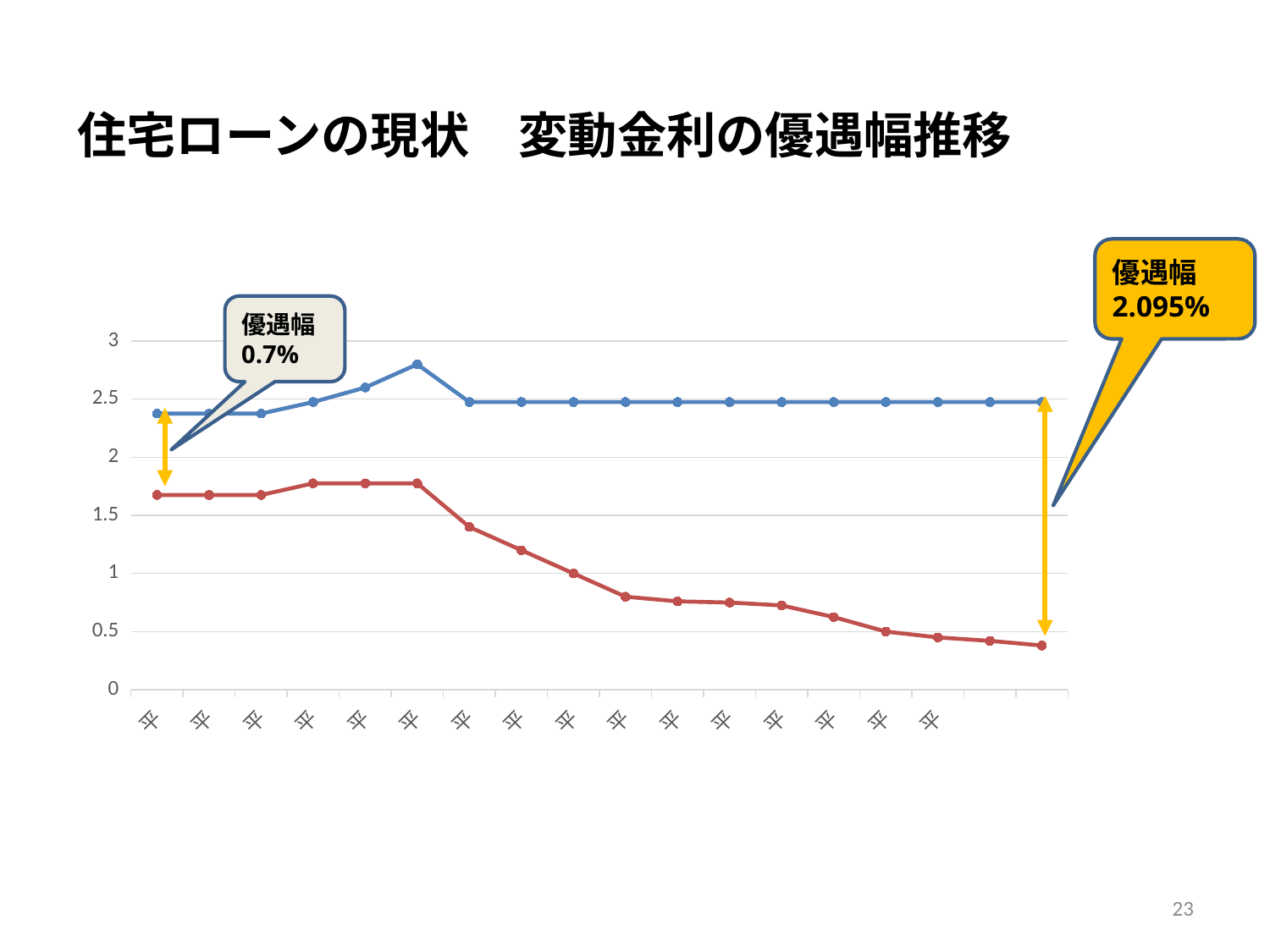
What 優遇幅 value is shown in the callout at the left (start) of the chart? 0.7% Is the highest point of the blue line greater or less than 2.5? greater Does the red line generally rise or fall from left to right across the chart? fall What 優遇幅 value is shown in the callout at the right (end) of the chart? 2.095% Is the value of the blue line at the last point greater or less than 2? greater What is the title of the slide containing the chart? 住宅ローンの現状 変動金利の優遇幅推移 How many lines (series) are plotted on the chart? 2 What kind of chart is shown on the slide? line chart Which line is higher at the right end of the chart, the blue line or the red line? the blue line Is the value of the red line at the first point greater or less than 1.5? greater What is the difference between the 優遇幅 at the end (2.095%) and at the start (0.7%) of the chart? 1.395%